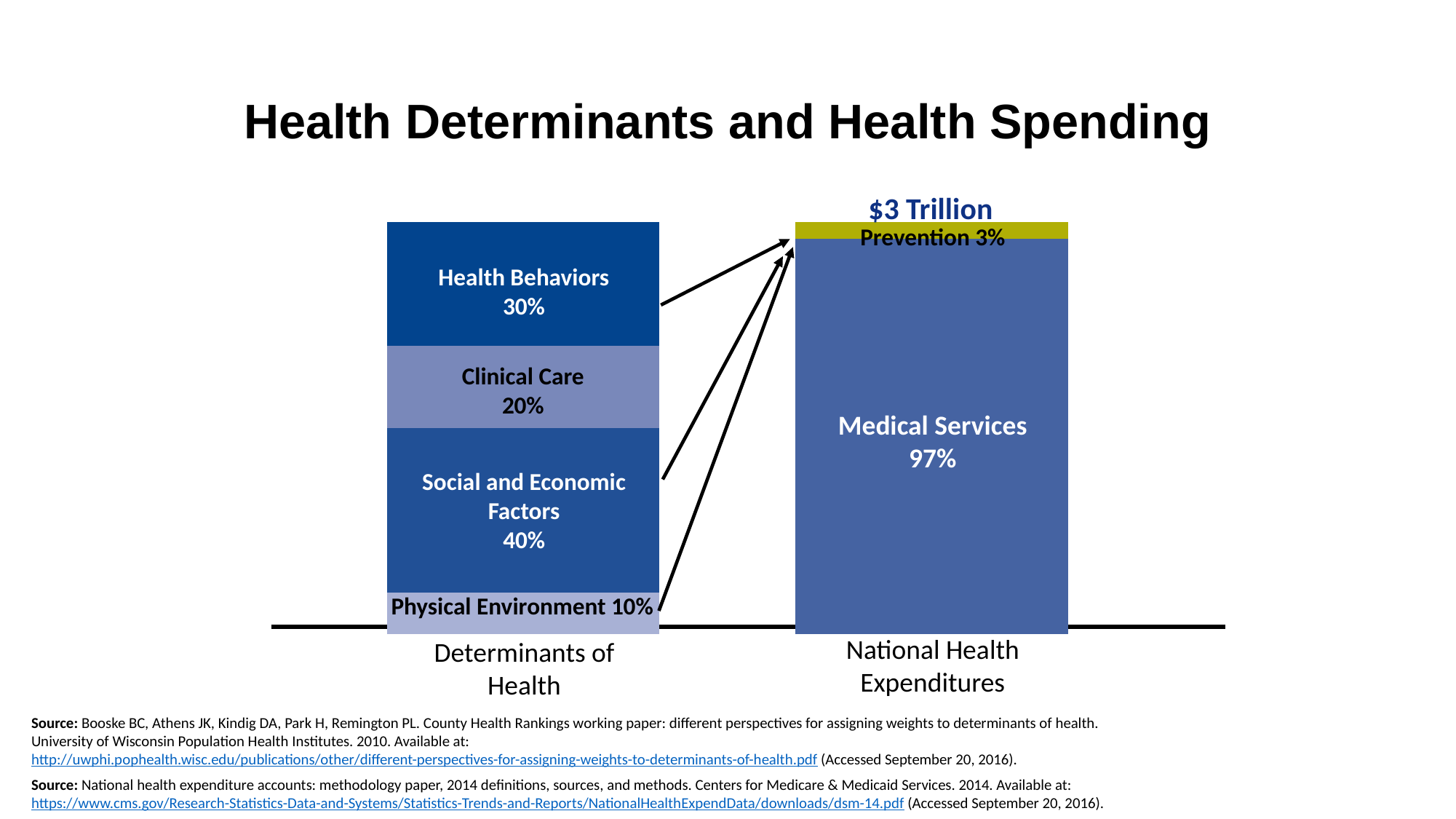
In the National Health Expenditures bar, which is larger: Medical Services or Prevention? Medical Services What total dollar amount is labeled above the National Health Expenditures bar? $3 Trillion What percentage is shown for Clinical Care in the Determinants of Health bar? 20% What percentage is shown for Social and Economic Factors in the Determinants of Health bar? 40% What percentage of National Health Expenditures goes to Medical Services? 97% What percentage is shown for Physical Environment in the Determinants of Health bar? 10% What percentage is shown for Health Behaviors in the Determinants of Health bar? 30% Which segment of the Determinants of Health bar is the smallest? Physical Environment What percentage of National Health Expenditures goes to Prevention? 3% What is the difference between the Social and Economic Factors share and the Clinical Care share in the Determinants of Health bar? 20% Which segment of the Determinants of Health bar is the largest? Social and Economic Factors How many segments make up the Determinants of Health bar? 4